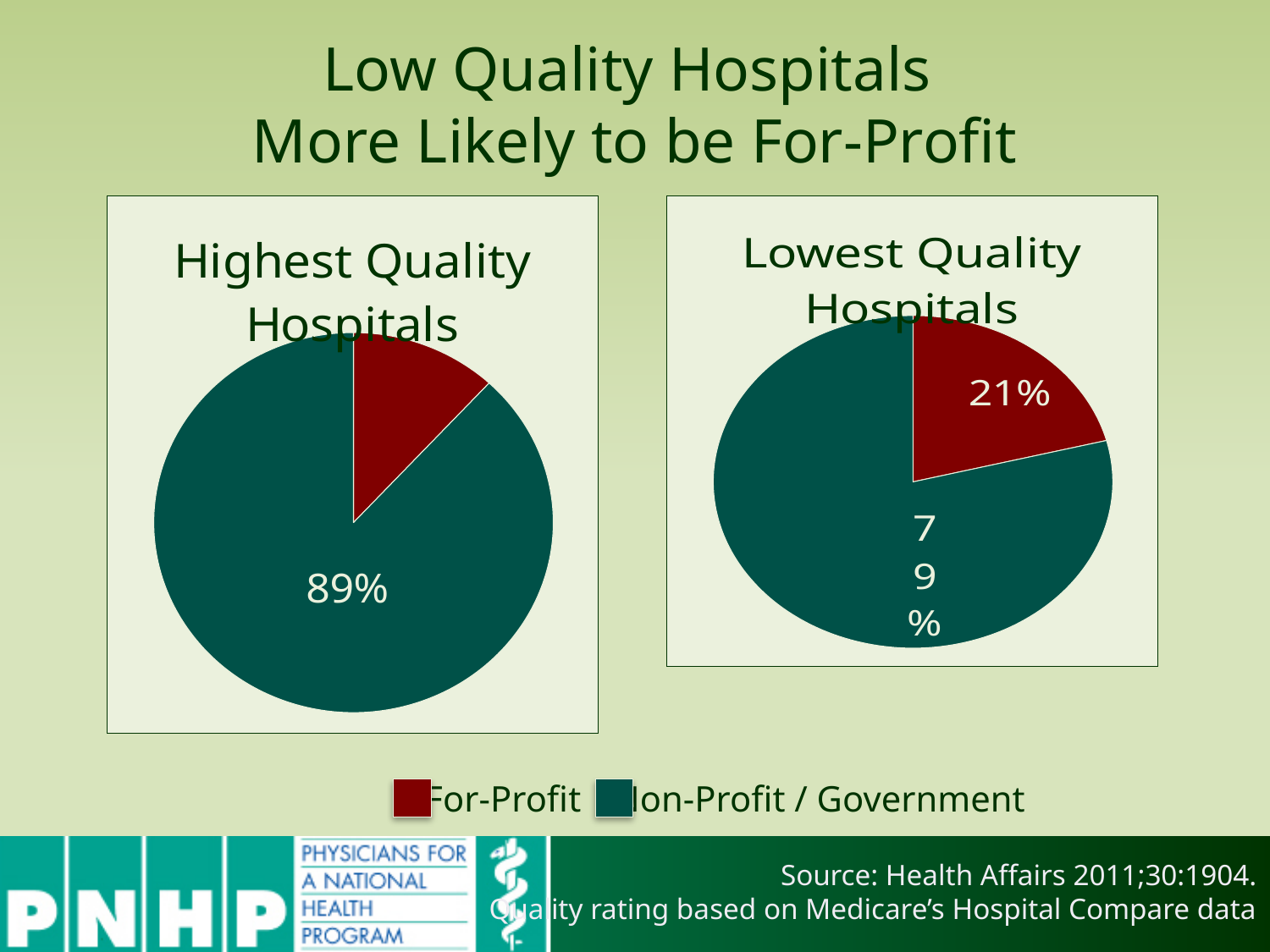
In the Lowest Quality Hospitals pie chart, which slice is the largest? Non-Profit / Government In the Highest Quality Hospitals pie chart, what share is Non-Profit / Government? 89% How many slices does the Lowest Quality Hospitals pie chart have? 2 What colour represents For-Profit in the legend? Red In the Highest Quality Hospitals pie chart, which slice is the smallest? For-Profit How many entries does the legend list? 2 In the Lowest Quality Hospitals pie chart, how many percentage points larger is the Non-Profit / Government share than the For-Profit share? 58 percentage points What is the title of the pie chart on the left? Highest Quality Hospitals In the Lowest Quality Hospitals pie chart, what share is Non-Profit / Government? 79% Is the For-Profit slice larger in the Highest Quality Hospitals chart or the Lowest Quality Hospitals chart? Lowest Quality Hospitals What kind of chart is used for the Highest Quality Hospitals data? Pie chart In the Lowest Quality Hospitals pie chart, what share is For-Profit? 21%